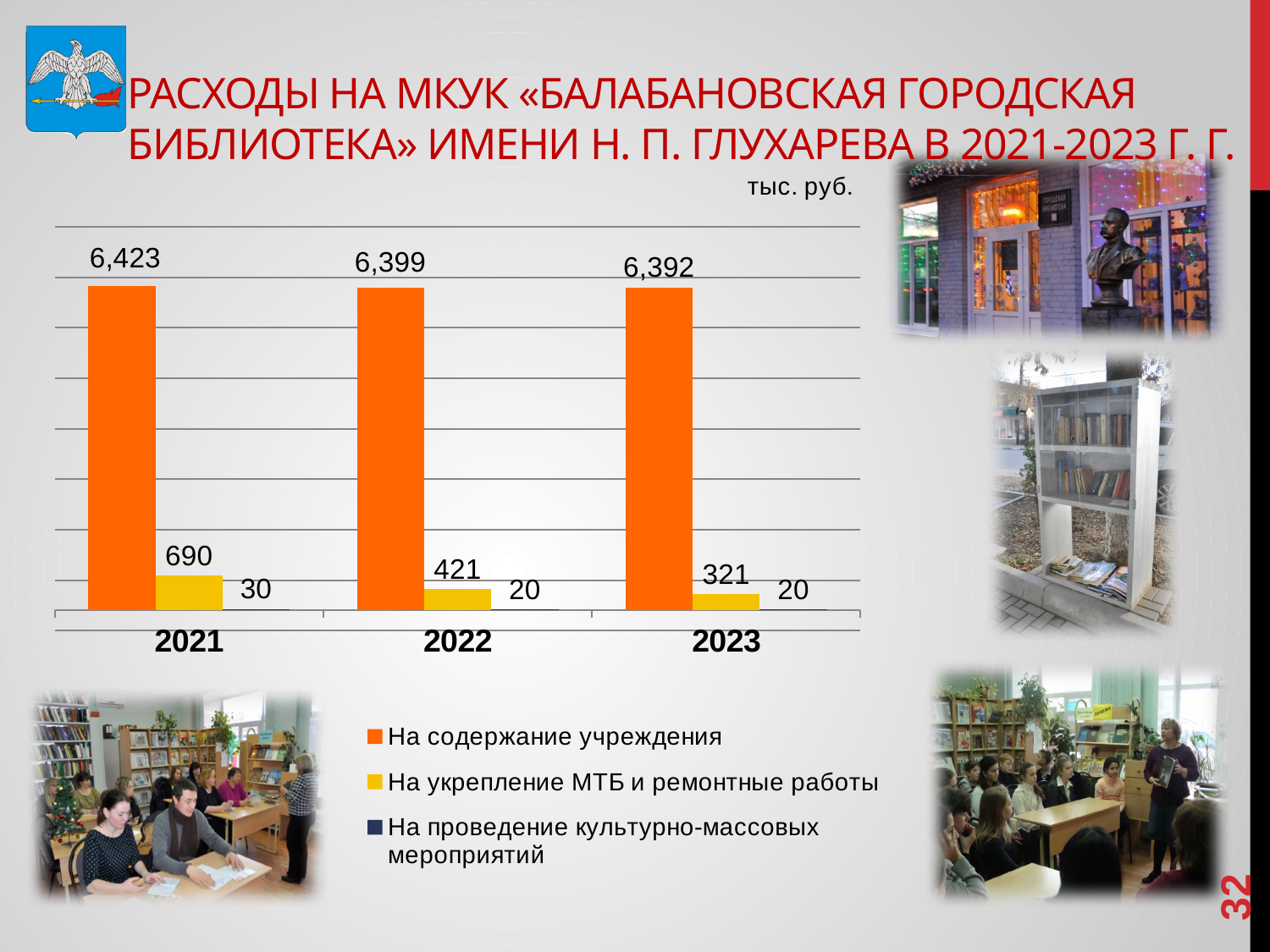
Какое значение расходов на проведение культурно-массовых мероприятий показано за 2021 год? 30 В каком году расходы на укрепление МТБ и ремонтные работы были наименьшими? 2023 Как изменяются расходы на укрепление МТБ и ремонтные работы с 2021 по 2023 год — растут или снижаются? Снижаются Сколько рядов данных перечислено в легенде диаграммы? 3 На сколько расходы на укрепление МТБ и ремонтные работы в 2021 году больше, чем в 2023 году? 369 В каком году расходы на укрепление МТБ и ремонтные работы были наибольшими? 2021 На сколько расходы на содержание учреждения в 2021 году больше, чем в 2022 году? 24 Какое значение расходов на укрепление МТБ и ремонтные работы показано за 2022 год? 421 Что больше: расходы на укрепление МТБ и ремонтные работы в 2022 году или в 2023 году? 2022 год Какое значение расходов на содержание учреждения показано за 2023 год? 6,392 Сколько лет (категорий) показано на оси x диаграммы? 3 Какое значение расходов на содержание учреждения показано за 2021 год? 6,423